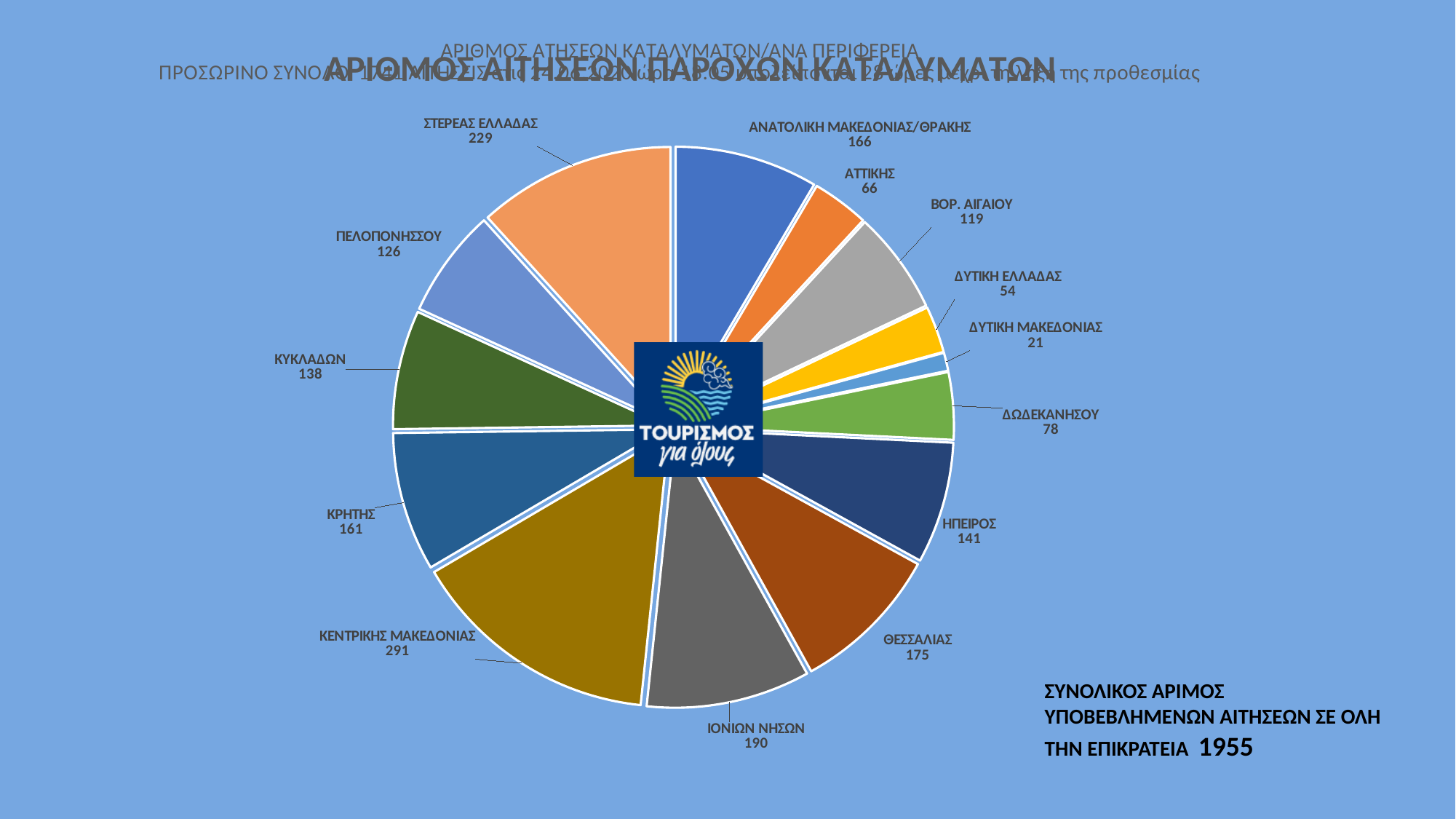
Which region has the lowest value? ΔΥΤΙΚΗ ΜΑΚΕΔΟΝΙΑΣ What is the value for ΚΕΝΤΡΙΚΗΣ ΜΑΚΕΔΟΝΙΑΣ? 291 What is the value for ΙΟΝΙΩΝ ΝΗΣΩΝ? 190 What is the value for ΒΟΡ. ΑΙΓΑΙΟΥ? 119 Which is larger, the value for ΘΕΣΣΑΛΙΑΣ or the value for ΑΝΑΤΟΛΙΚΗ ΜΑΚΕΔΟΝΙΑΣ/ΘΡΑΚΗΣ? ΘΕΣΣΑΛΙΑΣ What total number of submitted applications across the whole country is stated on the slide? 1955 What is the difference between the values for ΣΤΕΡΕΑΣ ΕΛΛΑΔΑΣ and ΚΡΗΤΗΣ? 68 How many regions (slices) does the pie chart show? 14 What is the value for ΔΥΤΙΚΗ ΜΑΚΕΔΟΝΙΑΣ? 21 What share of the total does ΚΕΝΤΡΙΚΗΣ ΜΑΚΕΔΟΝΙΑΣ represent? 14.9% Which region has the highest value? ΚΕΝΤΡΙΚΗΣ ΜΑΚΕΔΟΝΙΑΣ What type of chart is shown on the slide? pie chart